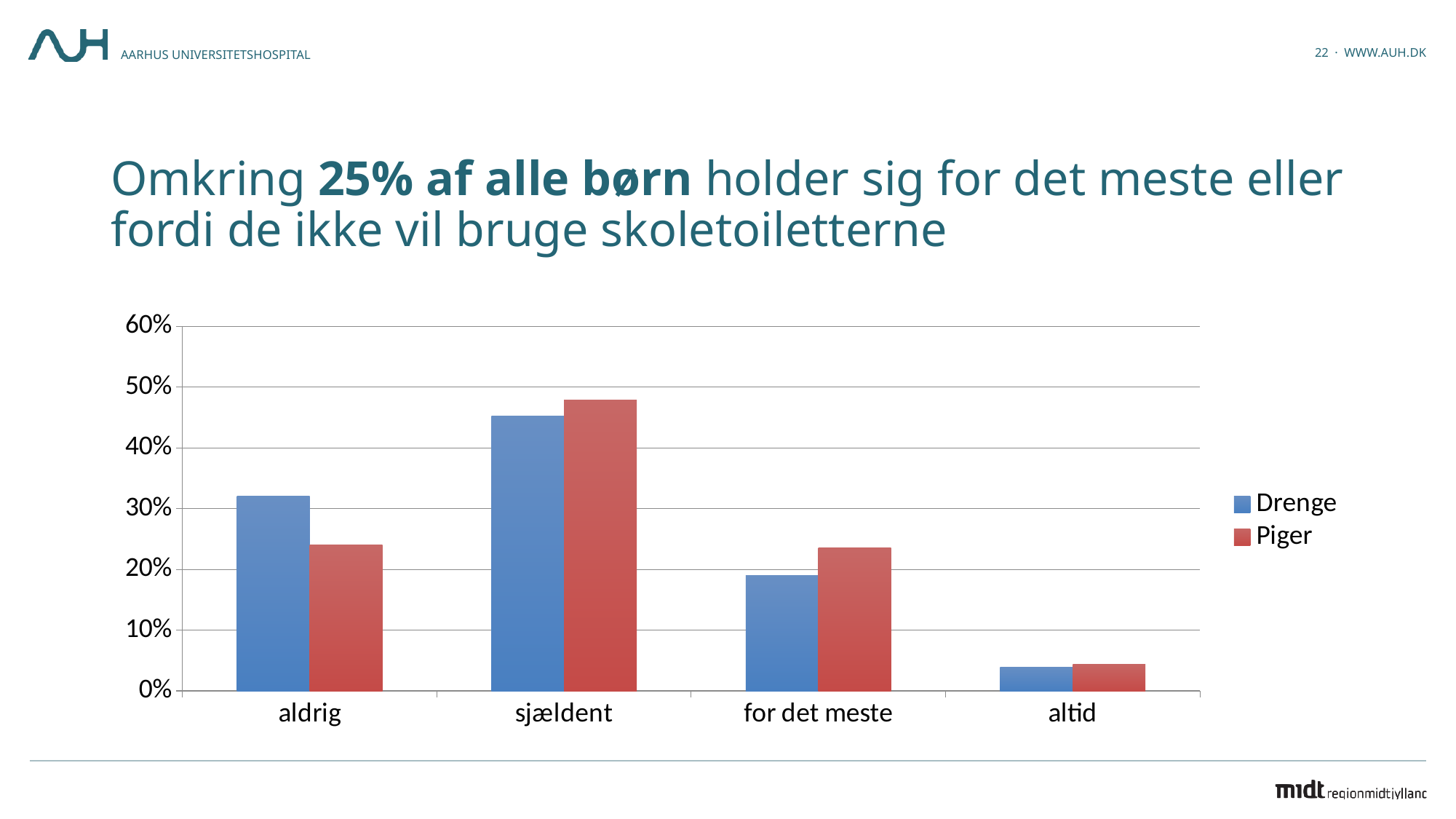
For the category 'for det meste', which series has the larger value, Drenge or Piger? Piger Is the value for Piger in the category 'altid' greater or less than 10%? less For the category 'sjældent', which series has the larger value, Drenge or Piger? Piger Which category has the highest value for Drenge? sjældent Which category has the lowest value for Piger? altid What are the two series named in the chart's legend? Drenge and Piger What kind of chart is shown on the slide? bar chart How many categories are shown on the x axis of the chart? 4 Is the value for Drenge in the category 'aldrig' greater or less than 30%? greater Is the value for Piger in the category 'sjældent' greater or less than 50%? less How many series does the chart's legend list? 2 For the category 'aldrig', which series has the larger value, Drenge or Piger? Drenge